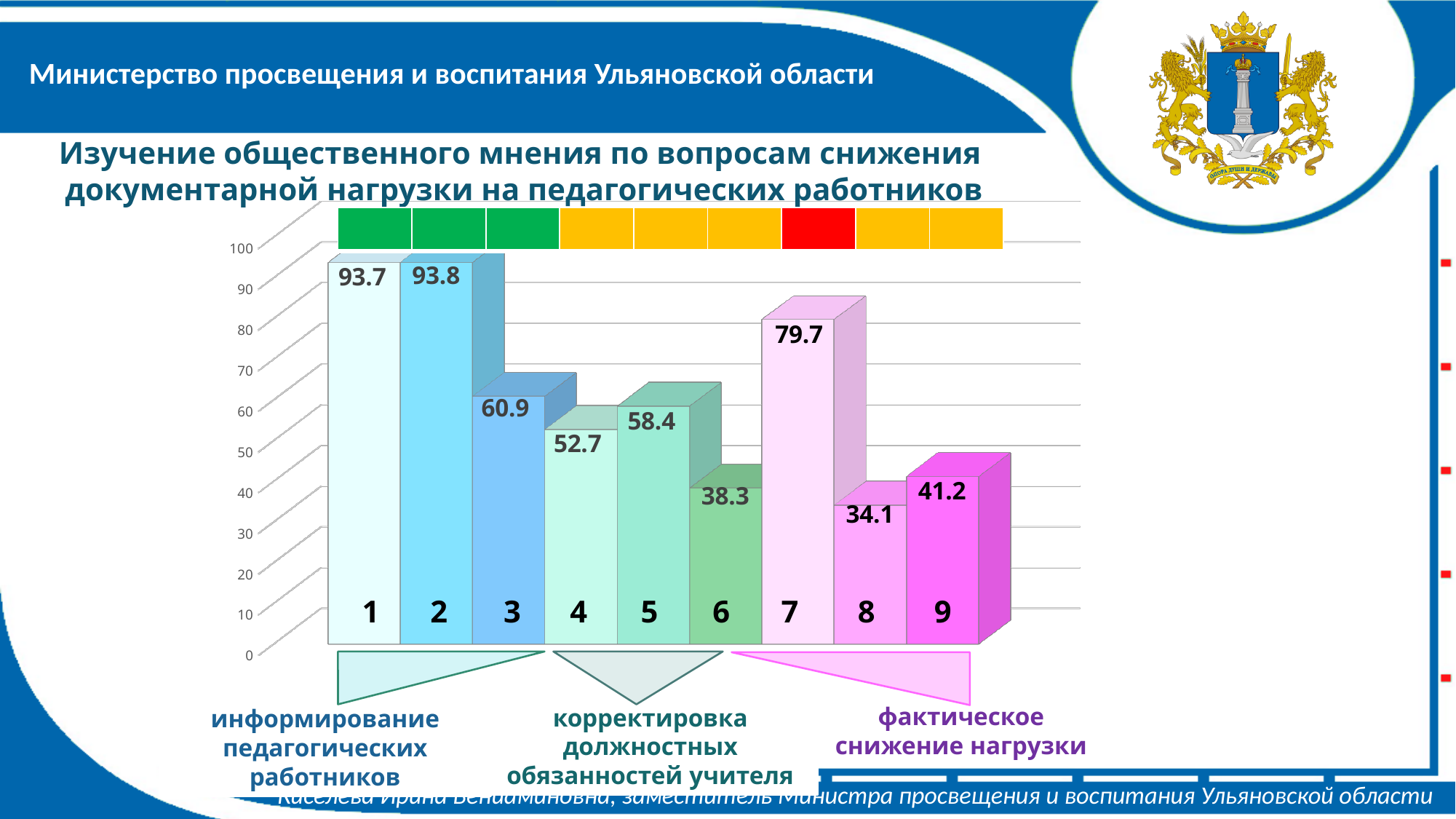
What is the difference between the values of bar 9 and bar 8? 7.1 What is the value shown for bar 3? 60.9 What is the highest tick value shown on the vertical axis? 100 Which is larger, the value for bar 4 or the value for bar 5? bar 5 What is the value shown for bar 7? 79.7 Which bar has the lowest value? 8 What is the value shown for bar 8? 34.1 What is the difference between the values of bar 1 and bar 3? 32.8 How many bars are plotted in the chart? 9 What kind of chart is shown on the slide? bar chart Which bar has the highest value? 2 Is the value for bar 6 greater or less than 40? less